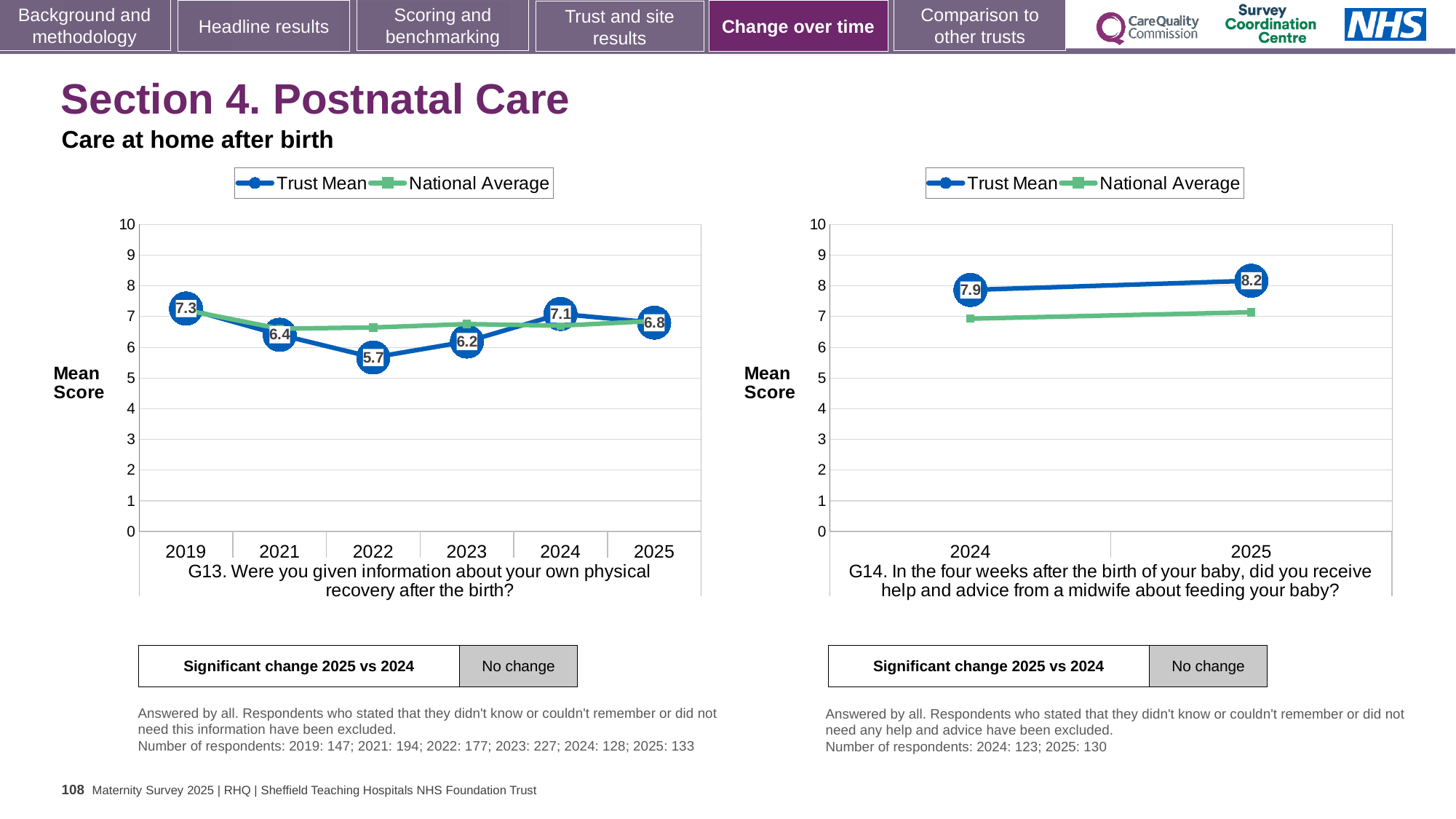
In the G13 chart, which year has the lowest Trust Mean? 2022 In the G13 chart, what is the difference between the Trust Mean for 2024 and 2025? 0.3 In the G13 chart, what is the Trust Mean for 2022? 5.7 How many years are plotted on the x axis of the G13 chart? 6 In the G14 chart, what is the Trust Mean for 2025? 8.2 In the G13 chart, what is the Trust Mean for 2019? 7.3 In the G14 chart, what is the difference between the Trust Mean for 2025 and 2024? 0.3 In the G13 chart, which year has the highest Trust Mean? 2019 What kind of chart is the G14 chart? Line chart In the G13 chart, is the National Average for 2022 greater or less than 7? less How many series does the legend of the G14 chart list? 2 In the G13 chart, is the Trust Mean higher in 2023 or in 2024? 2024